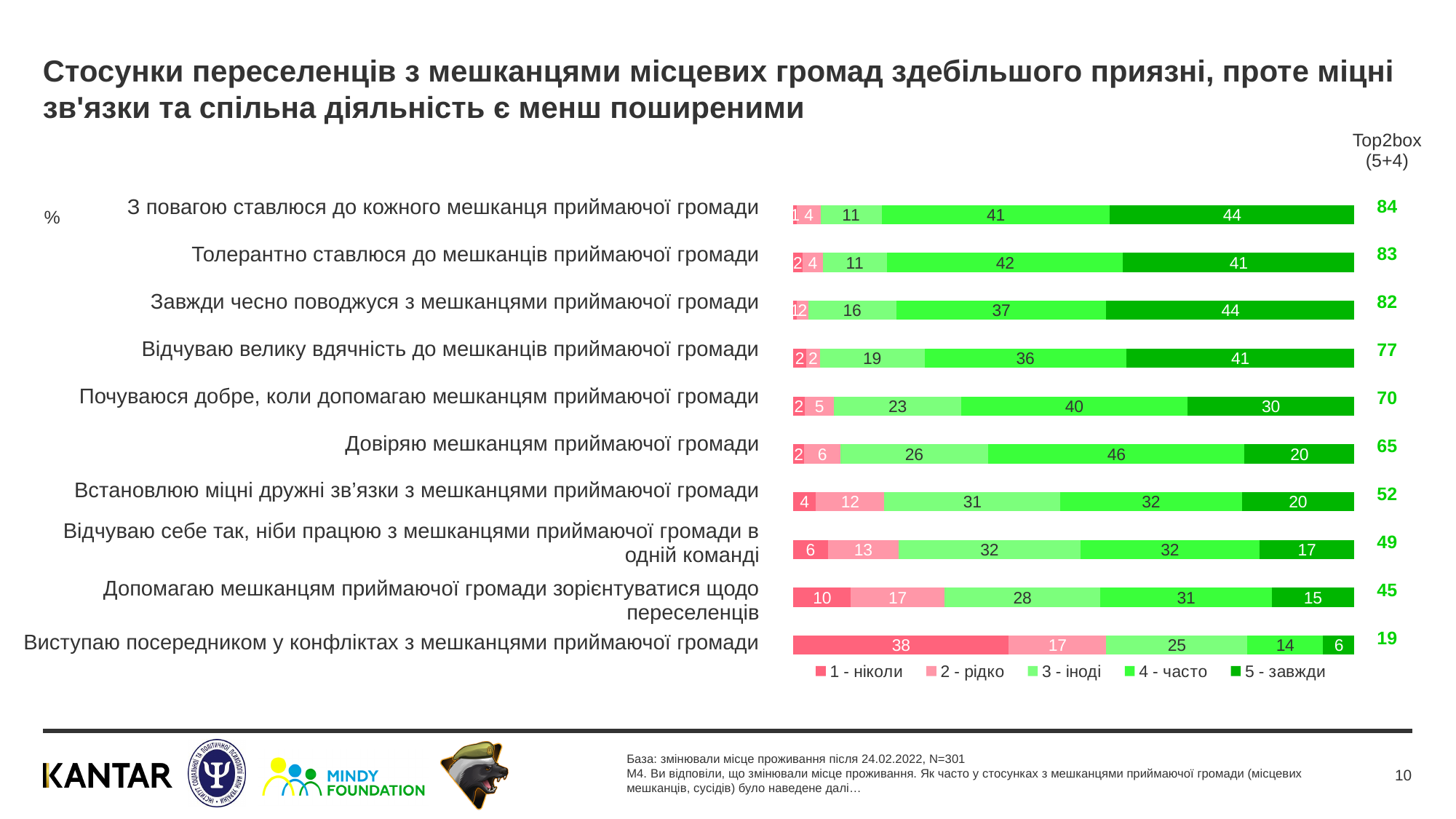
What is the Top2box (5+4) value for "Відчуваю велику вдячність до мешканців приймаючої громади"? 77 How many statements (categories) are plotted in the chart? 10 What is the combined value of "4 - часто" and "5 - завжди" for "Встановлюю міцні дружні зв’язки з мешканцями приймаючої громади"? 52 What kind of chart is shown on the slide? stacked bar chart What is the value of "1 - ніколи" for "Виступаю посередником у конфліктах з мешканцями приймаючої громади"? 38 Which statement has the lowest Top2box (5+4) value? Виступаю посередником у конфліктах з мешканцями приймаючої громади How many series does the chart legend list? 5 Which is larger: the "3 - іноді" value for "Довіряю мешканцям приймаючої громади" or for "Завжди чесно поводжуся з мешканцями приймаючої громади"? Довіряю мешканцям приймаючої громади What is the difference between the "4 - часто" value and the "5 - завжди" value for "Почуваюся добре, коли допомагаю мешканцям приймаючої громади"? 10 What is the label of the first series in the chart legend? 1 - ніколи Which statement has the highest value for "1 - ніколи"? Виступаю посередником у конфліктах з мешканцями приймаючої громади What is the value of "5 - завжди" for "Довіряю мешканцям приймаючої громади"? 20